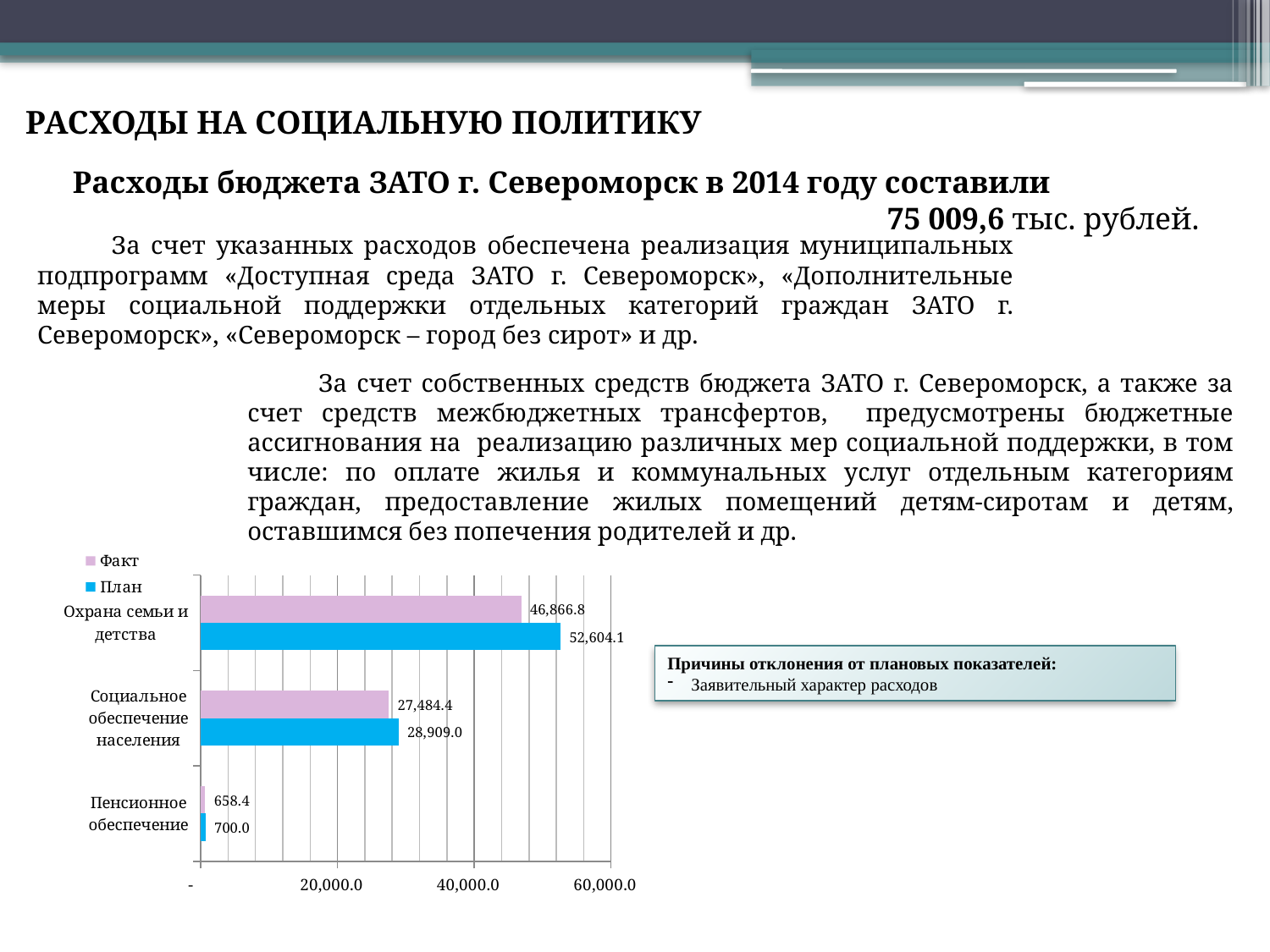
Which category has the highest План value? Охрана семьи и детства What kind of chart is shown on the slide? bar chart Is the Факт value for Охрана семьи и детства greater or less than 40,000.0? greater What is the План value for Охрана семьи и детства? 52,604.1 How many categories are shown on the chart? 3 Which category has the lowest Факт value? Пенсионное обеспечение What is the difference between the План and Факт values for Охрана семьи и детства? 5,737.3 What is the План value for Пенсионное обеспечение? 700.0 How many series does the legend list? 2 Which is larger for Социальное обеспечение населения, the План value or the Факт value? План What is the Факт value for Социальное обеспечение населения? 27,484.4 What is the Факт value for Пенсионное обеспечение? 658.4